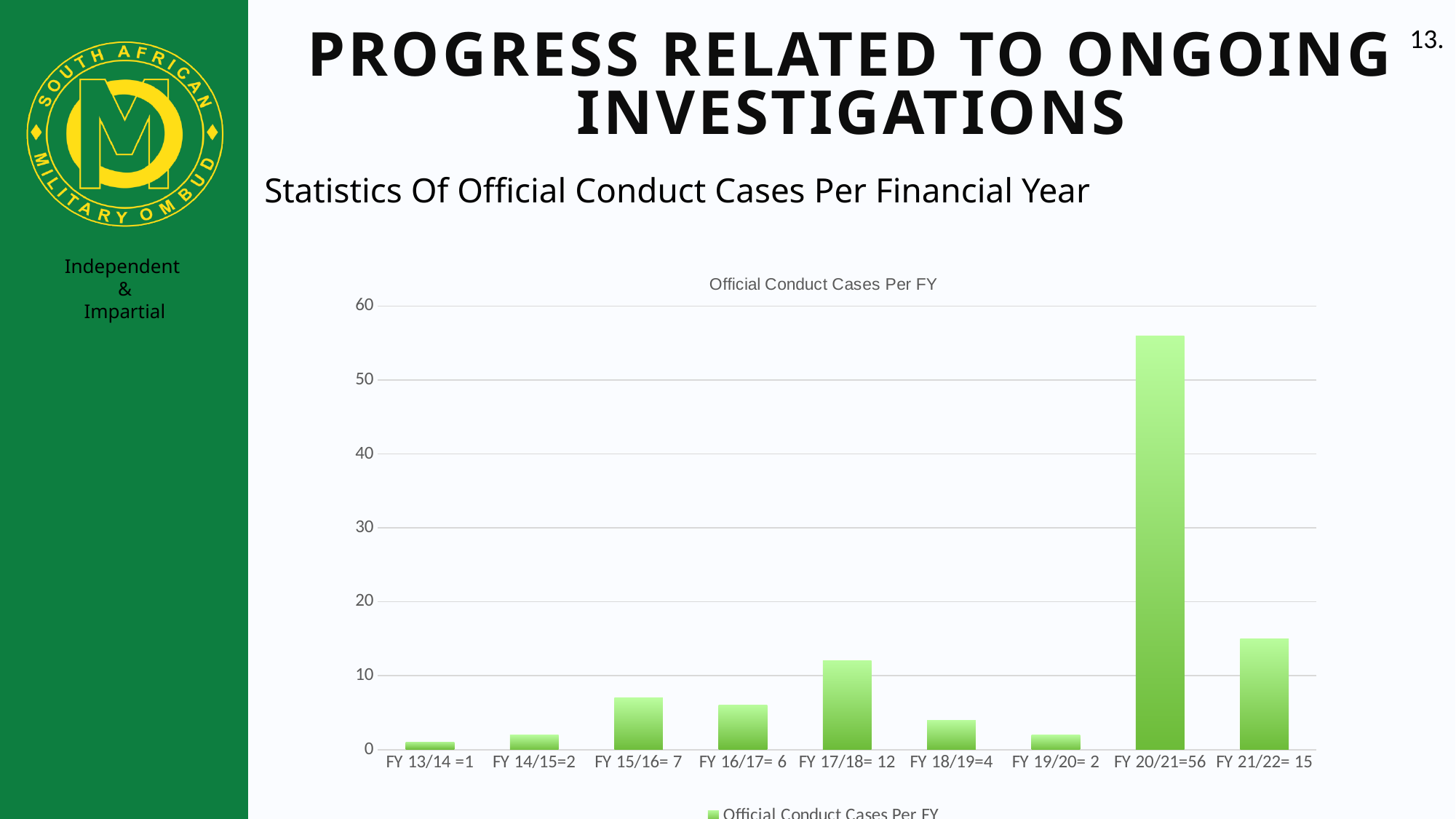
How many financial years are plotted in the chart? 9 How many official conduct cases were recorded in FY 20/21? 56 What is the difference in official conduct cases between FY 20/21 and FY 21/22? 41 What is the title of the chart? Official Conduct Cases Per FY Do the values rise or fall from FY 20/21 to FY 21/22? fall What type of chart is shown on the slide? bar chart How many series does the legend list? 1 Which financial year has the lowest number of official conduct cases? FY 13/14 Which has more official conduct cases, FY 15/16 or FY 16/17? FY 15/16 Is the value for FY 20/21 greater or less than 50? greater Which financial year has the highest number of official conduct cases? FY 20/21 How many official conduct cases were recorded in FY 17/18? 12